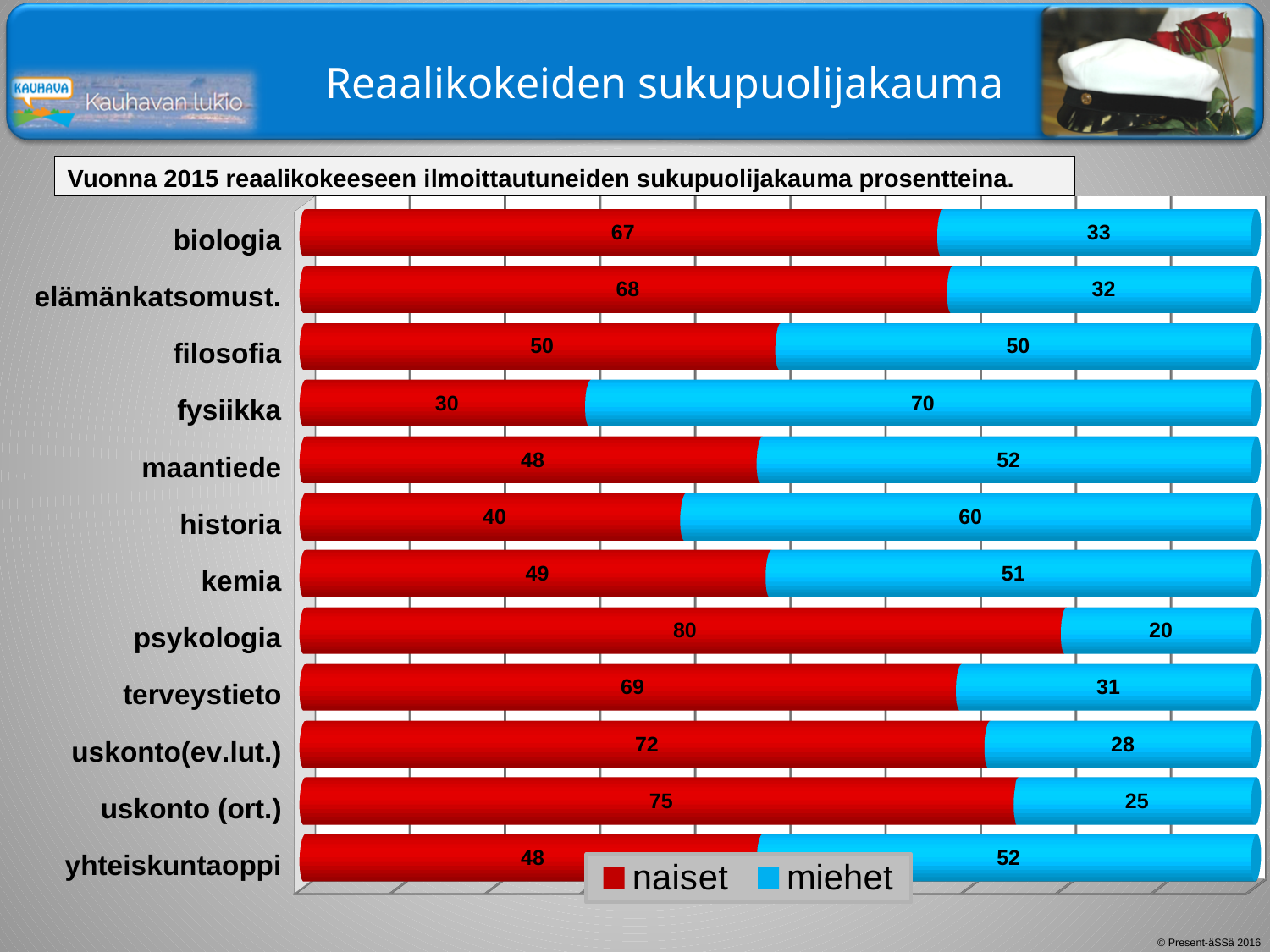
Which category has the lowest value for naiset? fysiikka What is the value for miehet in fysiikka? 70 What is the difference between the naiset and miehet values for historia? 20 Which category has the highest value for miehet? fysiikka Which category has the highest value for naiset? psykologia How many categories are shown in the chart? 12 What kind of chart is shown on the slide? stacked bar chart What is the value for naiset in uskonto (ort.)? 75 What is the value for naiset in psykologia? 80 Which is larger in maantiede, the naiset value or the miehet value? miehet How many series does the legend list? 2 What is the total of the stacked bar for kemia? 100